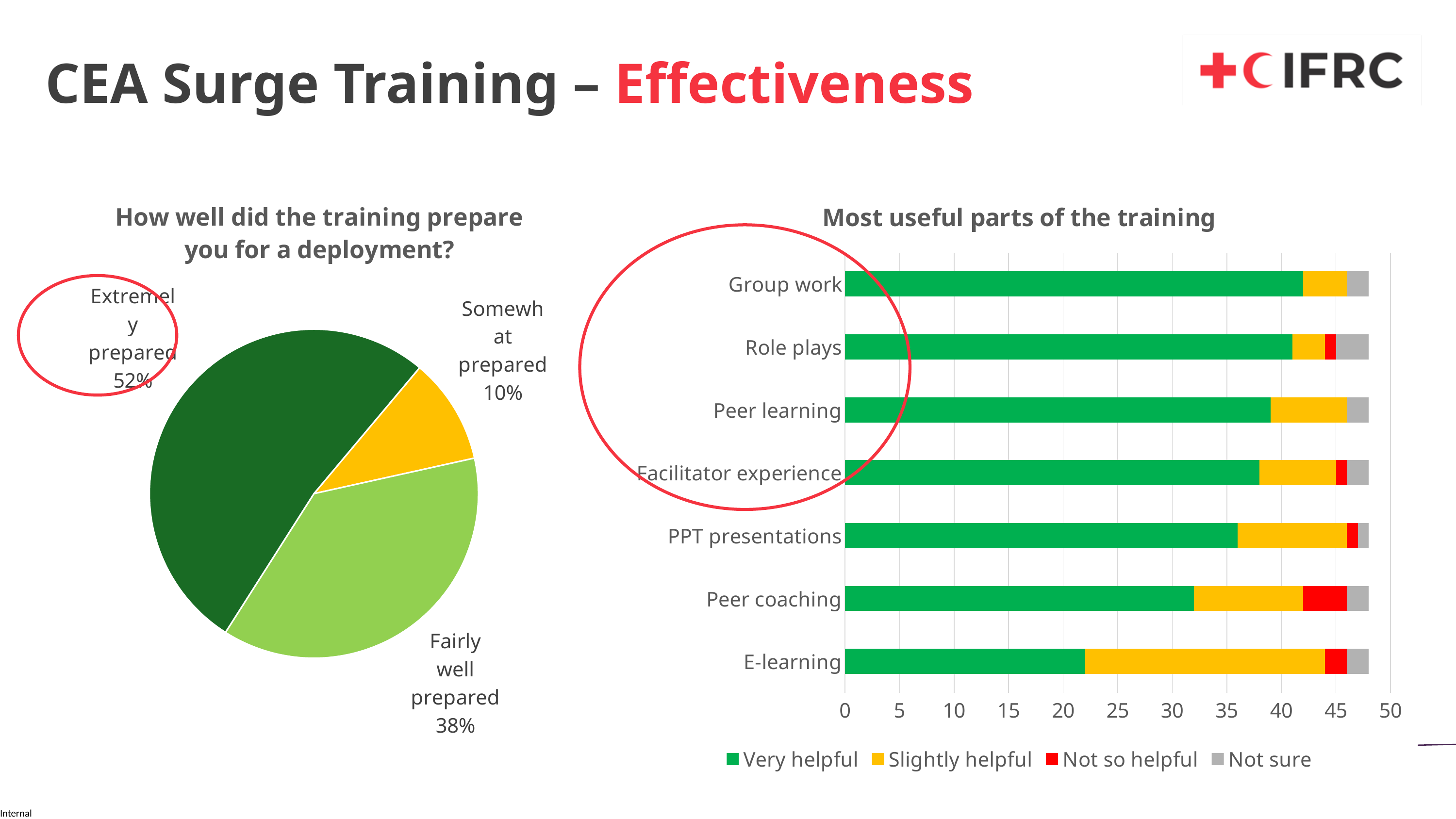
In the chart 'How well did the training prepare you for a deployment?', what share of respondents were extremely prepared? 52% What kind of chart is 'Most useful parts of the training'? Stacked bar chart In the chart 'Most useful parts of the training', which category has the largest 'Very helpful' segment? Group work What kind of chart is 'How well did the training prepare you for a deployment?' Pie chart How many series does the legend of the chart 'Most useful parts of the training' list? 4 In the chart 'How well did the training prepare you for a deployment?', which category has the smallest share? Somewhat prepared How many categories are shown in the chart 'Most useful parts of the training'? 7 In the chart 'How well did the training prepare you for a deployment?', which category has the largest share? Extremely prepared In the chart 'How well did the training prepare you for a deployment?', what share of respondents were fairly well prepared? 38% In the chart 'How well did the training prepare you for a deployment?', what is the difference in percentage points between 'Extremely prepared' and 'Fairly well prepared'? 14 In the chart 'Most useful parts of the training', is the 'Very helpful' value for E-learning greater or less than 25? less In the chart 'How well did the training prepare you for a deployment?', what share of respondents were somewhat prepared? 10%